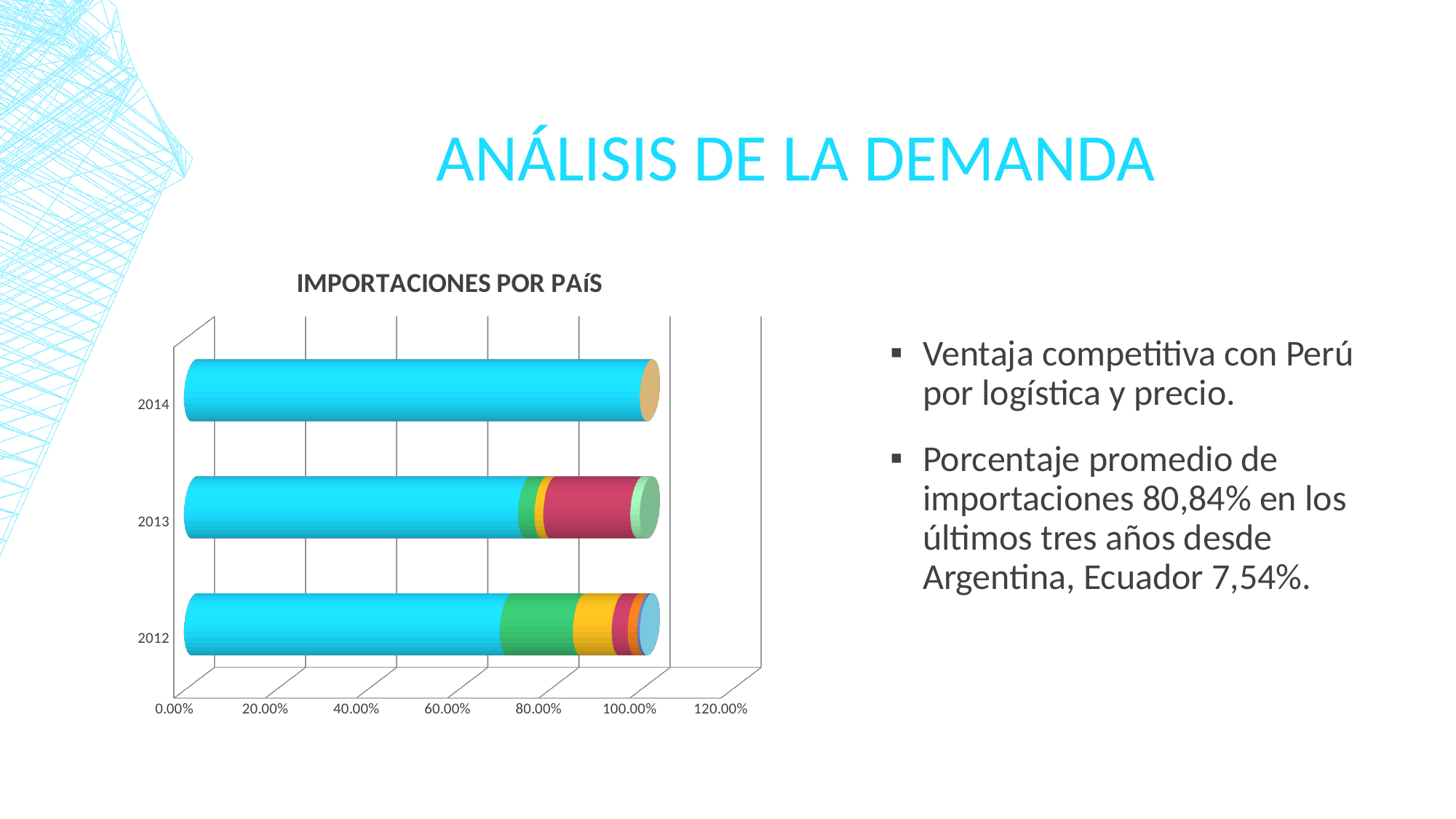
How many years (categories) are plotted on the IMPORTACIONES POR PAíS chart? 3 Is the cyan segment for 2013 greater or less than 60.00%? greater What is the title of the chart on the slide? IMPORTACIONES POR PAíS Is the cyan segment for 2012 greater or less than 80.00%? less Which year's bar has the largest cyan (first) segment? 2014 What kind of chart is shown under the title IMPORTACIONES POR PAíS? Stacked bar chart Which year has a larger cyan segment, 2013 or 2012? 2013 Which year's bar has the smallest cyan (first) segment? 2012 What is the highest value shown on the horizontal axis of the chart? 120.00% Does the cyan (first) segment grow or shrink going from 2012 up to 2014? grows Is the cyan segment for 2014 greater or less than 80.00%? greater